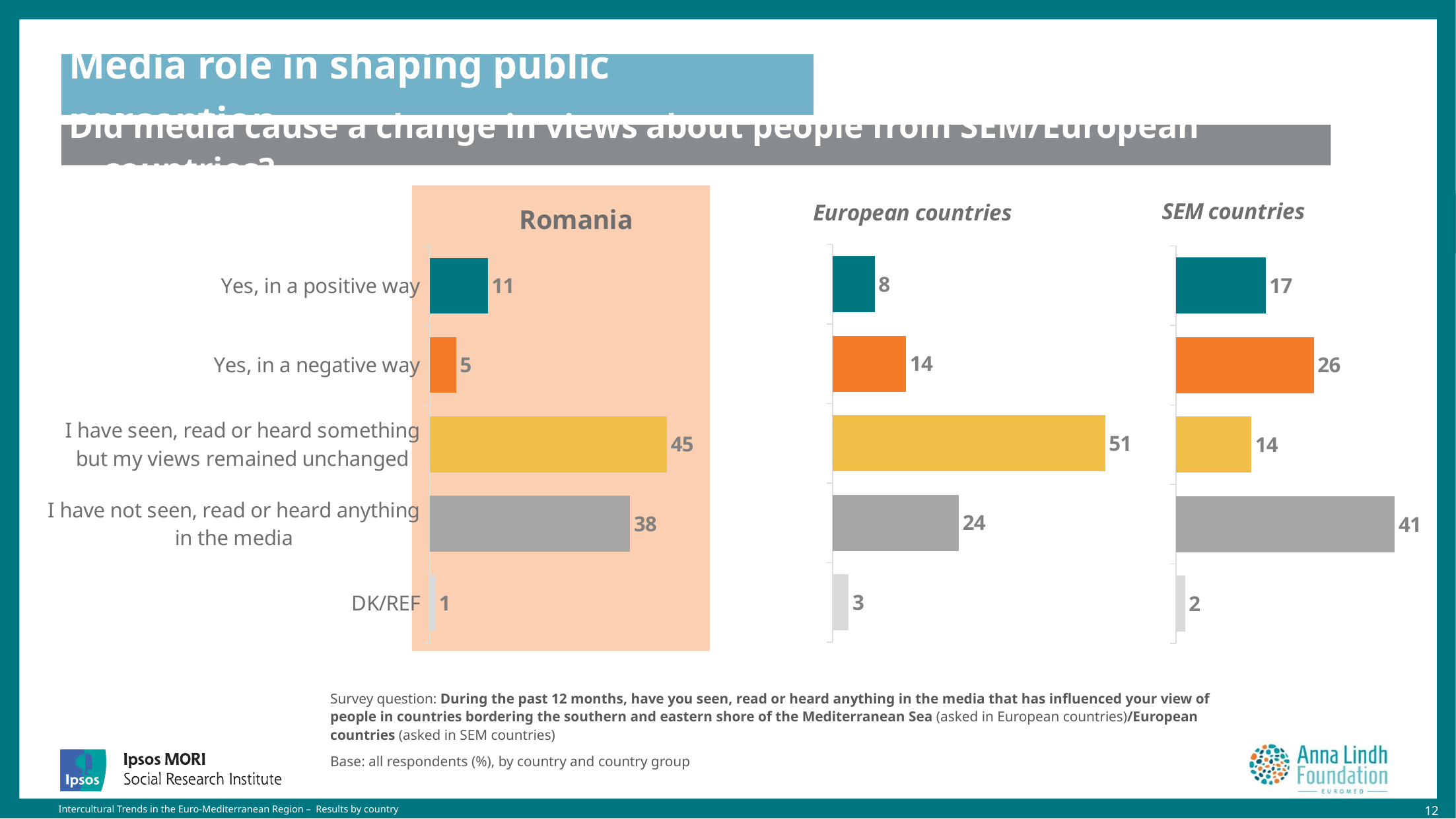
In the SEM countries chart, what is the value for 'Yes, in a negative way'? 26 Which is larger: 'Yes, in a negative way' in the Romania chart or 'Yes, in a negative way' in the European countries chart? European countries In the European countries chart, what is the value for DK/REF? 3 What type of chart is used for the Romania data? Bar chart In the Romania chart, which category has the highest value? I have seen, read or heard something but my views remained unchanged How many categories are shown in the Romania chart? 5 In the European countries chart, what is the value for 'I have seen, read or heard something but my views remained unchanged'? 51 In the Romania chart, what is the value for 'Yes, in a positive way'? 11 In the SEM countries chart, what is the difference between 'Yes, in a negative way' and 'Yes, in a positive way'? 9 In the Romania chart, what is the difference between 'I have seen, read or heard something but my views remained unchanged' and 'I have not seen, read or heard anything in the media'? 7 In the European countries chart, which category has the lowest value? DK/REF In the SEM countries chart, which category has the highest value? I have not seen, read or heard anything in the media